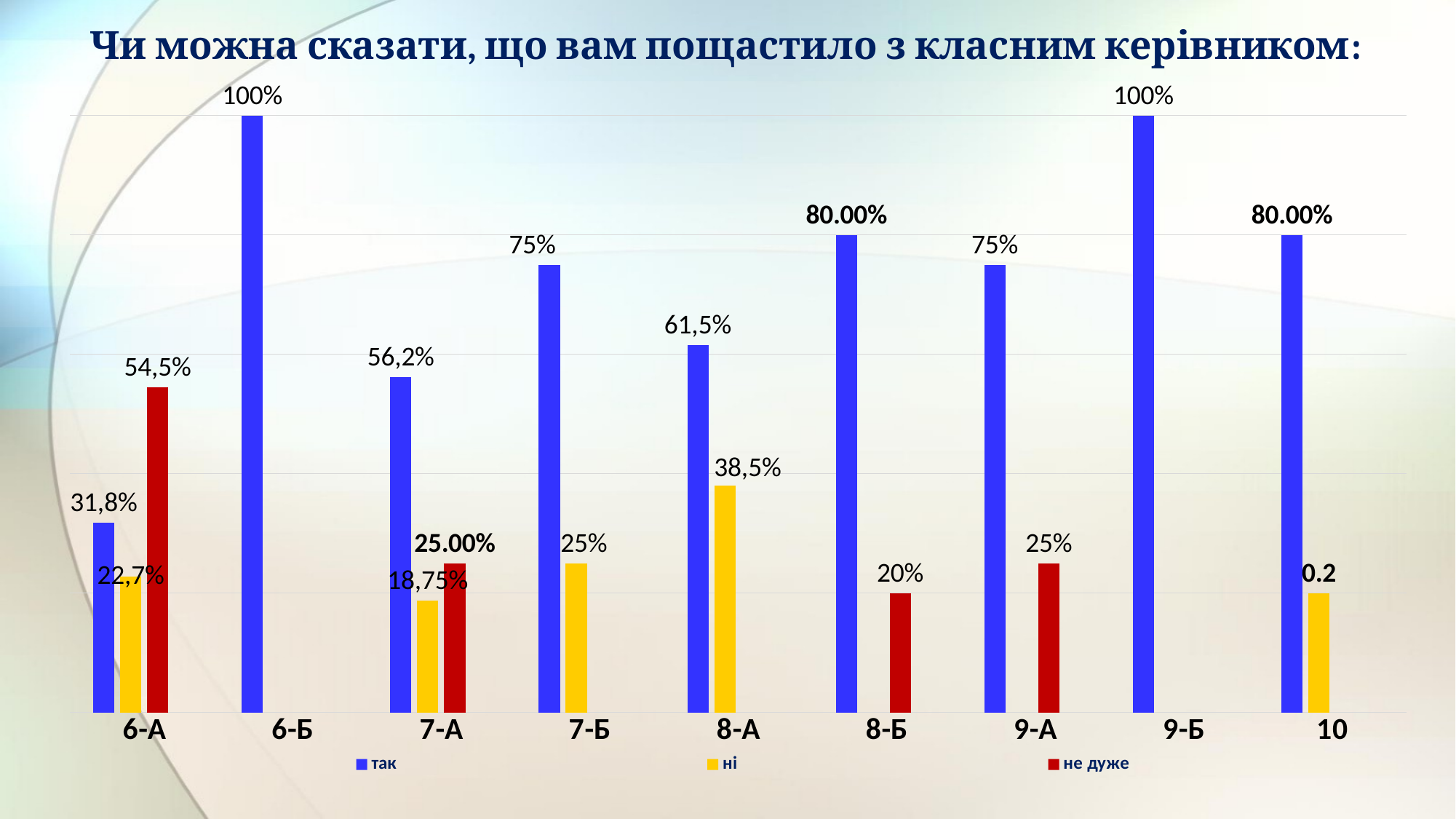
How many series does the legend list? 3 Which class has the lowest value for "так"? 6-А What is the value of "ні" for class 7-А? 18,75% What is the value of "не дуже" for class 6-А? 54,5% What is the value of "так" for class 8-А? 61,5% What is the value of "ні" for class 10? 0.2 What kind of chart is shown on the slide? bar chart Which class has the highest value for "не дуже"? 6-А What is the difference between "так" and "ні" for class 7-Б? 50% How many class categories are shown on the x axis? 9 What is the value of "так" for class 6-А? 31,8% Which is larger for class 8-Б: "так" or "не дуже"? так